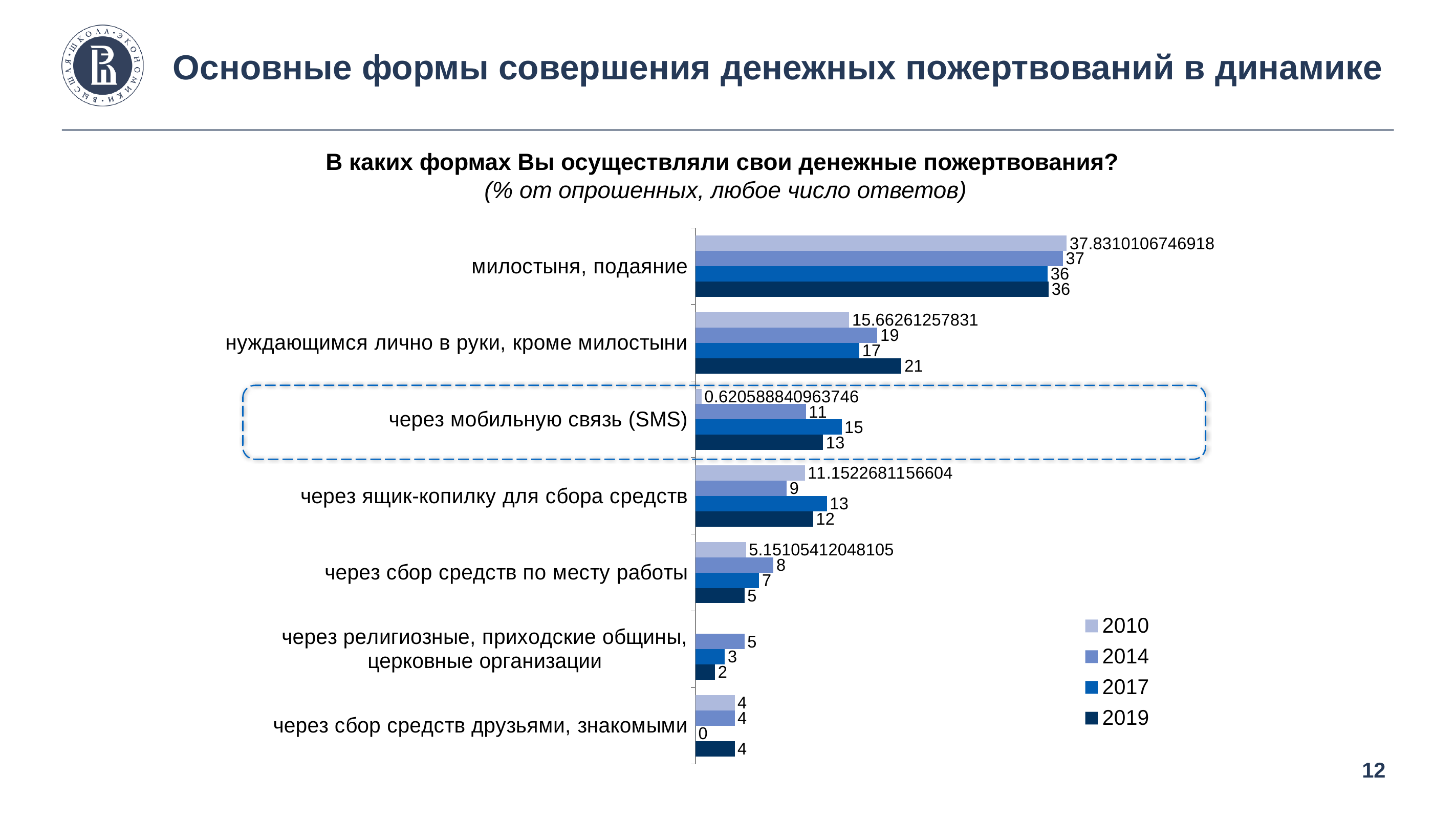
How many categories are shown on the chart? 7 What is the 2014 value for "нуждающимся лично в руки, кроме милостыни"? 19 Which category has the lowest 2017 value? через сбор средств друзьями, знакомыми Which category is highlighted with a dashed outline on the chart? через мобильную связь (SMS) What is the 2019 value for "через мобильную связь (SMS)"? 13 Which category has the highest 2019 value? милостыня, подаяние What kind of chart is shown on the slide? bar chart What is the 2017 value for "через ящик-копилку для сбора средств"? 13 How many series does the legend list? 4 What is the difference between the 2019 and 2017 values for "нуждающимся лично в руки, кроме милостыни"? 4 For "через мобильную связь (SMS)", which is larger: the 2014 value or the 2017 value? 2017 What is the 2019 value for "через религиозные, приходские общины, церковные организации"? 2